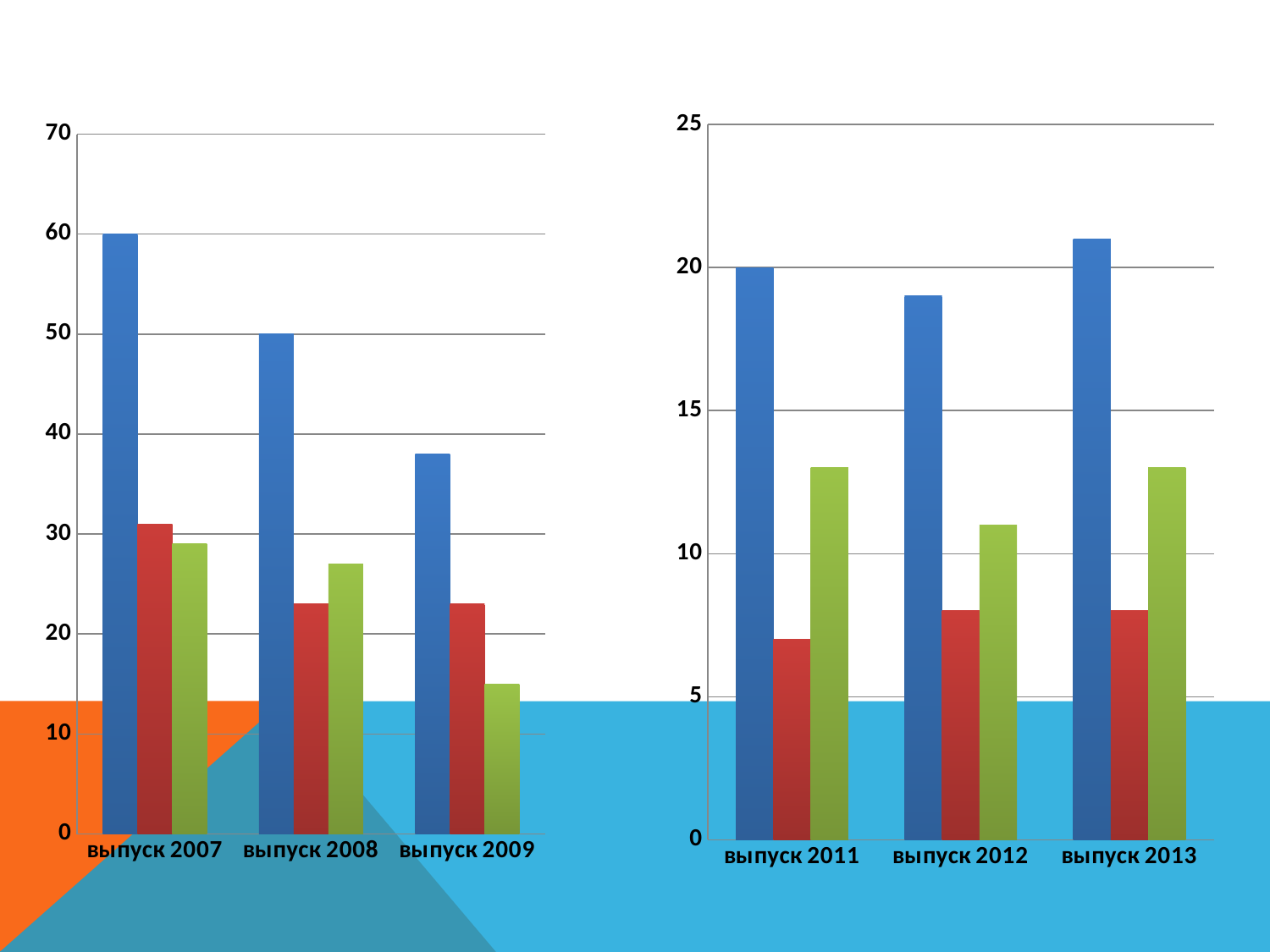
In the chart on the right side of the slide, is the value of the red bar for выпуск 2011 greater or less than 10? less How many categories are shown on the x axis of the chart on the right side of the slide? 3 In the chart on the right side of the slide, is the value of the blue bar for выпуск 2013 greater or less than 20? greater In the chart on the left side of the slide, which category has the tallest bar? выпуск 2007 In the chart on the right side of the slide, for выпуск 2012, which bar is taller, the red bar or the green bar? the green bar In the chart on the left side of the slide, is the value of the green bar for выпуск 2009 greater or less than 20? less What kind of chart is the chart on the left side of the slide? bar chart In the chart on the right side of the slide, what is the value of the blue bar for выпуск 2011? 20 In the chart on the left side of the slide, do the blue bars rise or fall from выпуск 2007 to выпуск 2009? fall In the chart on the left side of the slide, what is the value of the blue bar for выпуск 2007? 60 In the chart on the left side of the slide, what is the value of the blue bar for выпуск 2008? 50